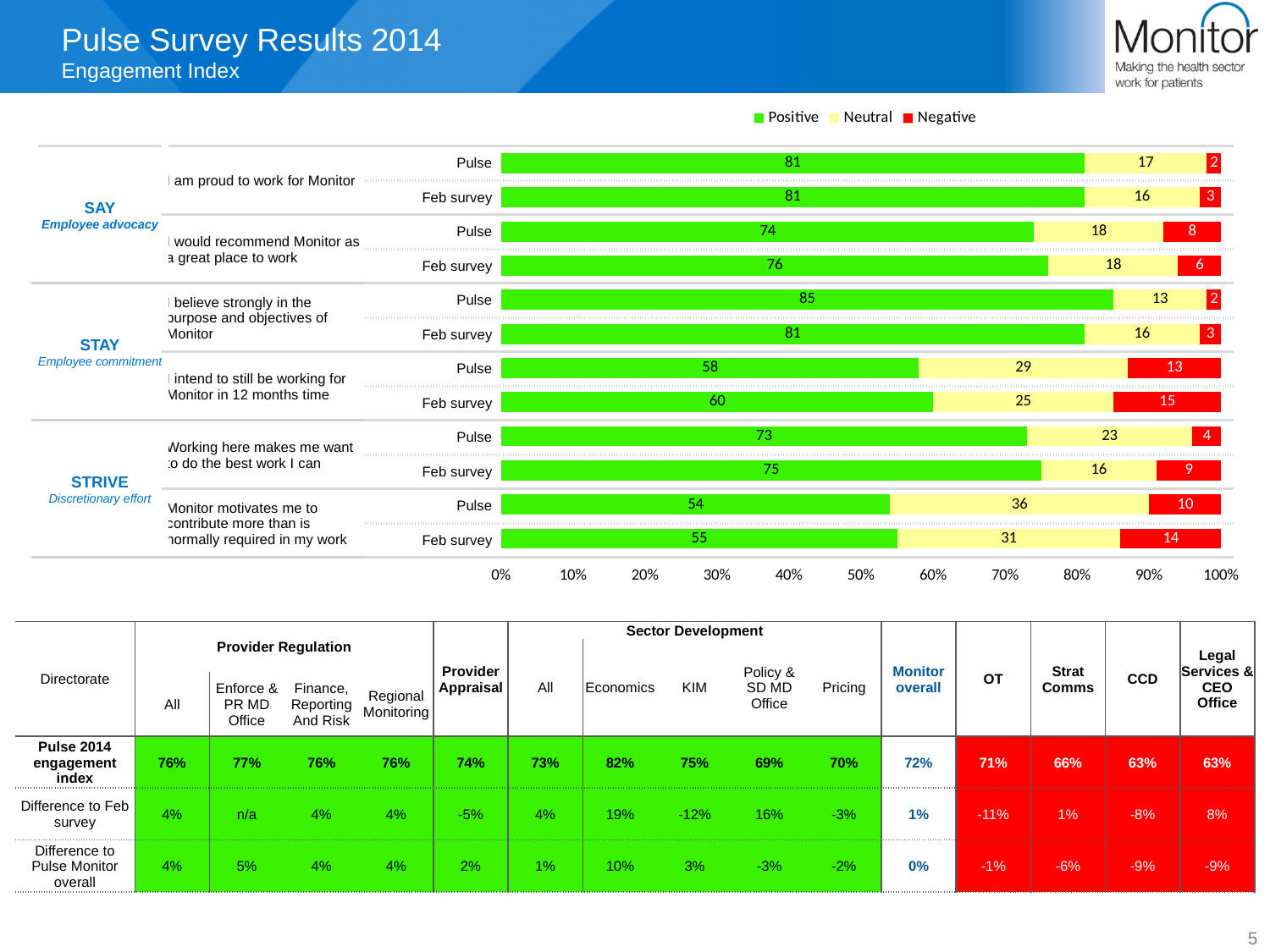
Which bar has the highest Positive value in the chart? Pulse, 'I believe strongly in the purpose and objectives of Monitor' (85) Which bar has the lowest Positive value in the chart? Pulse, 'Monitor motivates me to contribute more than is normally required in my work' (54) For 'Working here makes me want to do the best work I can', which has the larger Positive value, the Pulse bar or the Feb survey bar? Feb survey How many series does the chart legend list? 3 For 'I intend to still be working for Monitor in 12 months time', what is the difference between the Feb survey Negative value and the Pulse Negative value? 2 What is the Positive value for the Pulse bar of 'I believe strongly in the purpose and objectives of Monitor'? 85 What colour represents the Negative series in the chart legend? red What is the total of the Pulse bar for 'I am proud to work for Monitor' (Positive + Neutral + Negative)? 100 How many bars are plotted in the chart? 12 What is the Neutral value for the Pulse bar of 'Monitor motivates me to contribute more than is normally required in my work'? 36 What is the Negative value for the Pulse bar of 'I would recommend Monitor as a great place to work'? 8 What kind of chart is shown on the slide? bar chart